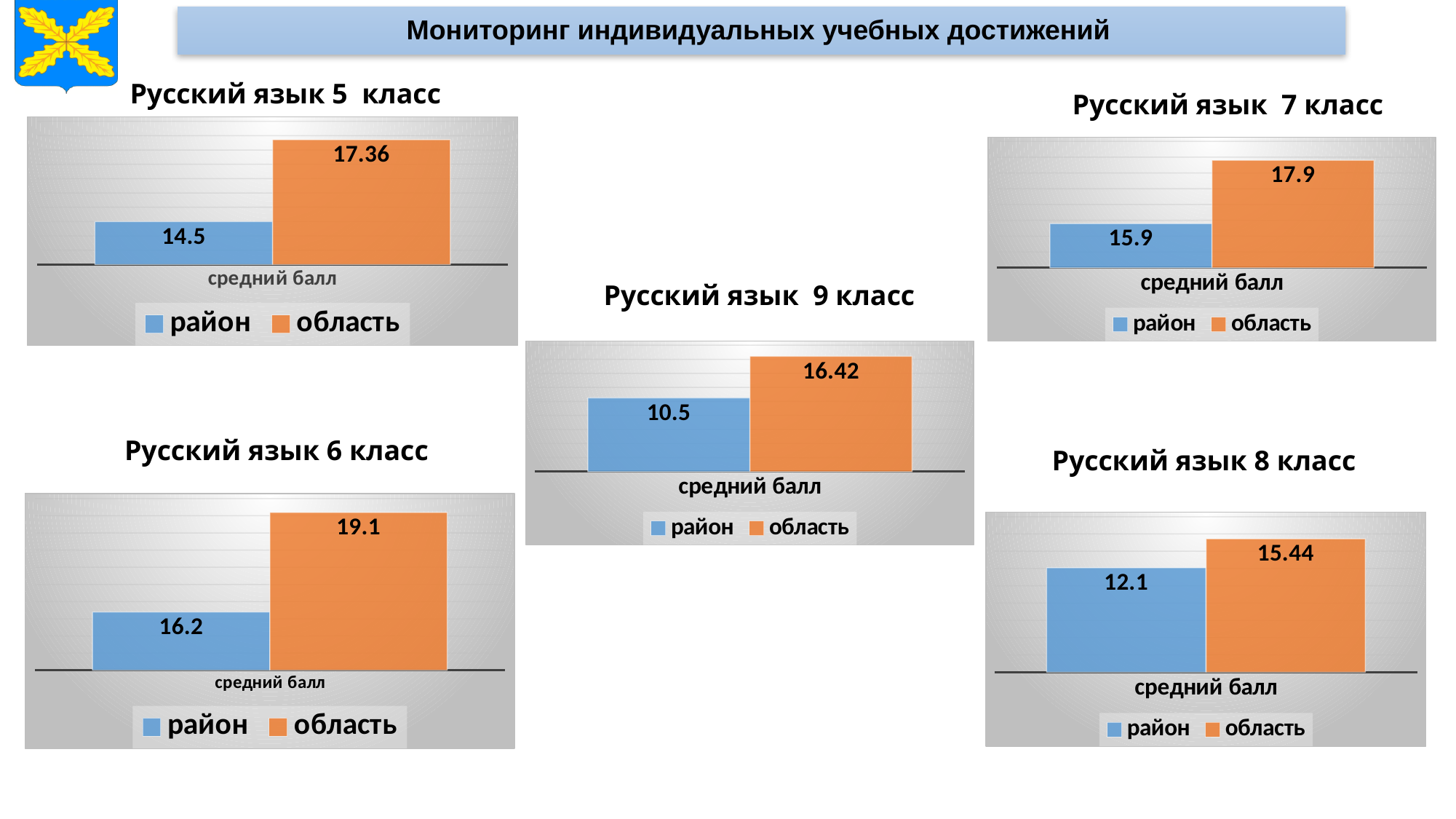
In the 'Русский язык 9 класс' chart, what is the difference between область and район? 5.92 How many series does the legend of the 'Русский язык 5 класс' chart list? 2 In the 'Русский язык 5 класс' chart, what is the value for область? 17.36 In the 'Русский язык 7 класс' chart, what is the value for район? 15.9 What kind of chart is the 'Русский язык 9 класс' chart? bar chart In the 'Русский язык 8 класс' chart, what is the value for район? 12.1 In the 'Русский язык 6 класс' chart, what is the value for область? 19.1 In the 'Русский язык 6 класс' chart, what is the difference between область and район? 2.9 In the 'Русский язык 5 класс' chart, what is the value for район? 14.5 In the 'Русский язык 9 класс' chart, what is the value for область? 16.42 In the 'Русский язык 7 класс' chart, which series has the highest value? область In the 'Русский язык 8 класс' chart, which is larger, район or область? область